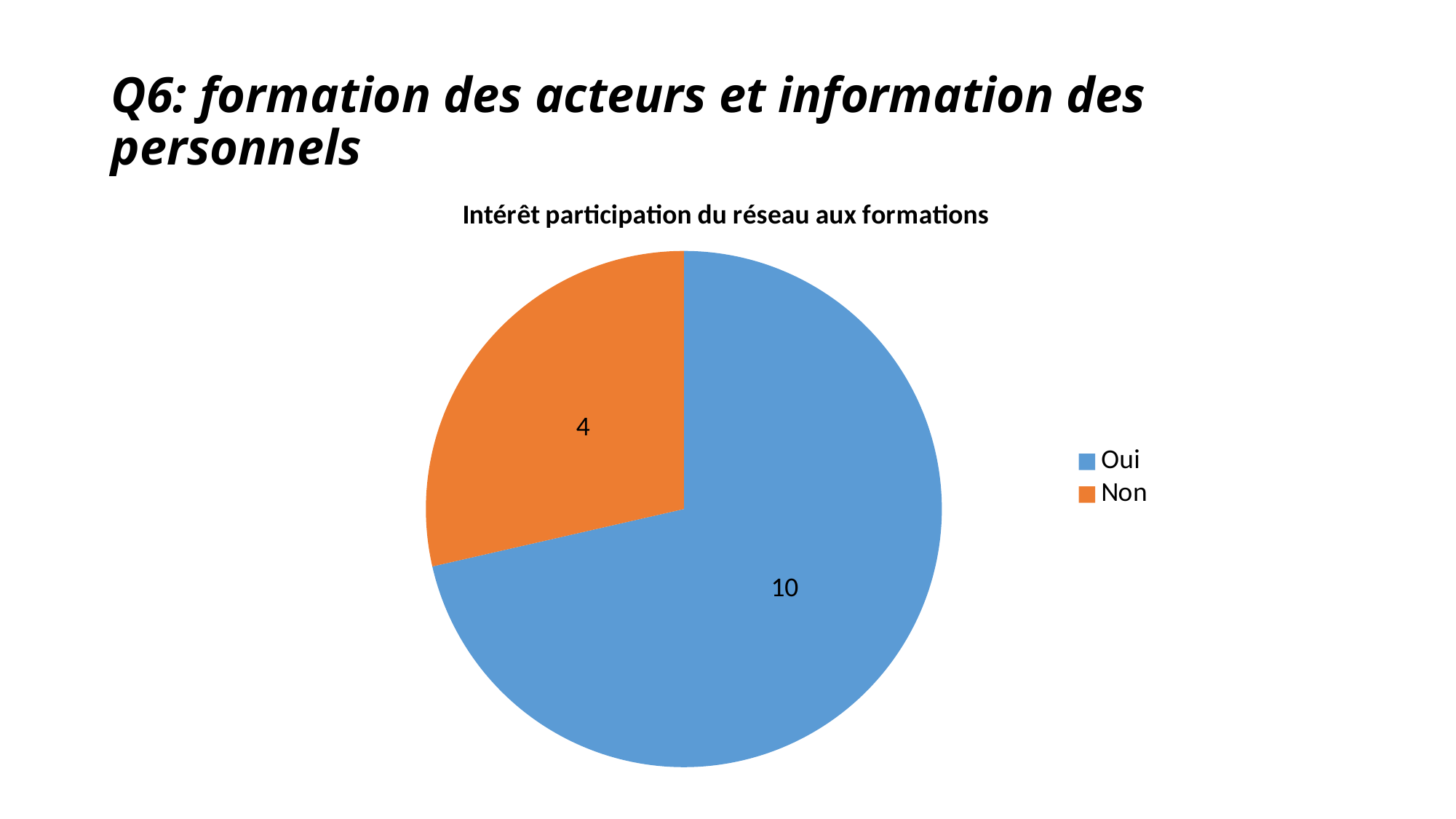
Which is larger, the value for Oui or the value for Non? Oui How many slices does the pie chart have? 2 What type of chart is shown on the slide? pie chart What is the value for Non? 4 Which category has the smallest slice? Non What is the total of all slices in the pie chart? 14 What is the title of the chart? Intérêt participation du réseau aux formations What colour is the Non slice? orange What is the value for Oui? 10 What is the difference between the values for Oui and Non? 6 Which category has the largest slice? Oui